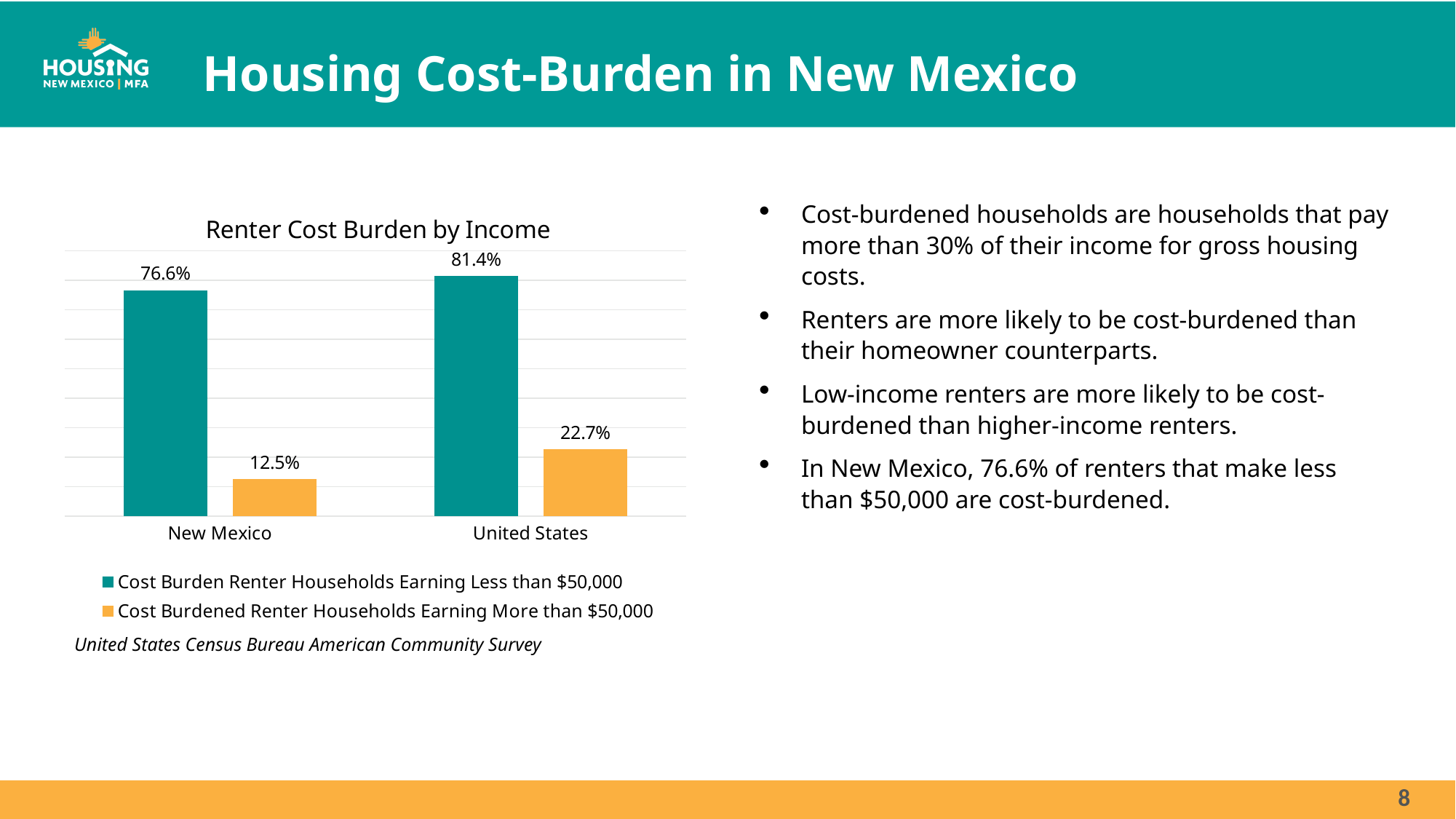
What is the value for Cost Burden Renter Households Earning Less than $50,000 in the United States? 81.4% Which bar in the chart has the highest value? United States, Cost Burden Renter Households Earning Less than $50,000 How many categories are shown on the x axis of the chart? 2 What is the value for Cost Burdened Renter Households Earning More than $50,000 in the United States? 22.7% What type of chart is shown on the slide? Bar chart Which bar in the chart has the lowest value? New Mexico, Cost Burdened Renter Households Earning More than $50,000 How many series does the chart legend list? 2 What is the difference between the Less than $50,000 values for the United States and New Mexico? 4.8% Which is larger: the Less than $50,000 value for New Mexico or for the United States? United States What is the difference between the More than $50,000 values for the United States and New Mexico? 10.2% What is the value for Cost Burden Renter Households Earning Less than $50,000 in New Mexico? 76.6% What is the value for Cost Burdened Renter Households Earning More than $50,000 in New Mexico? 12.5%